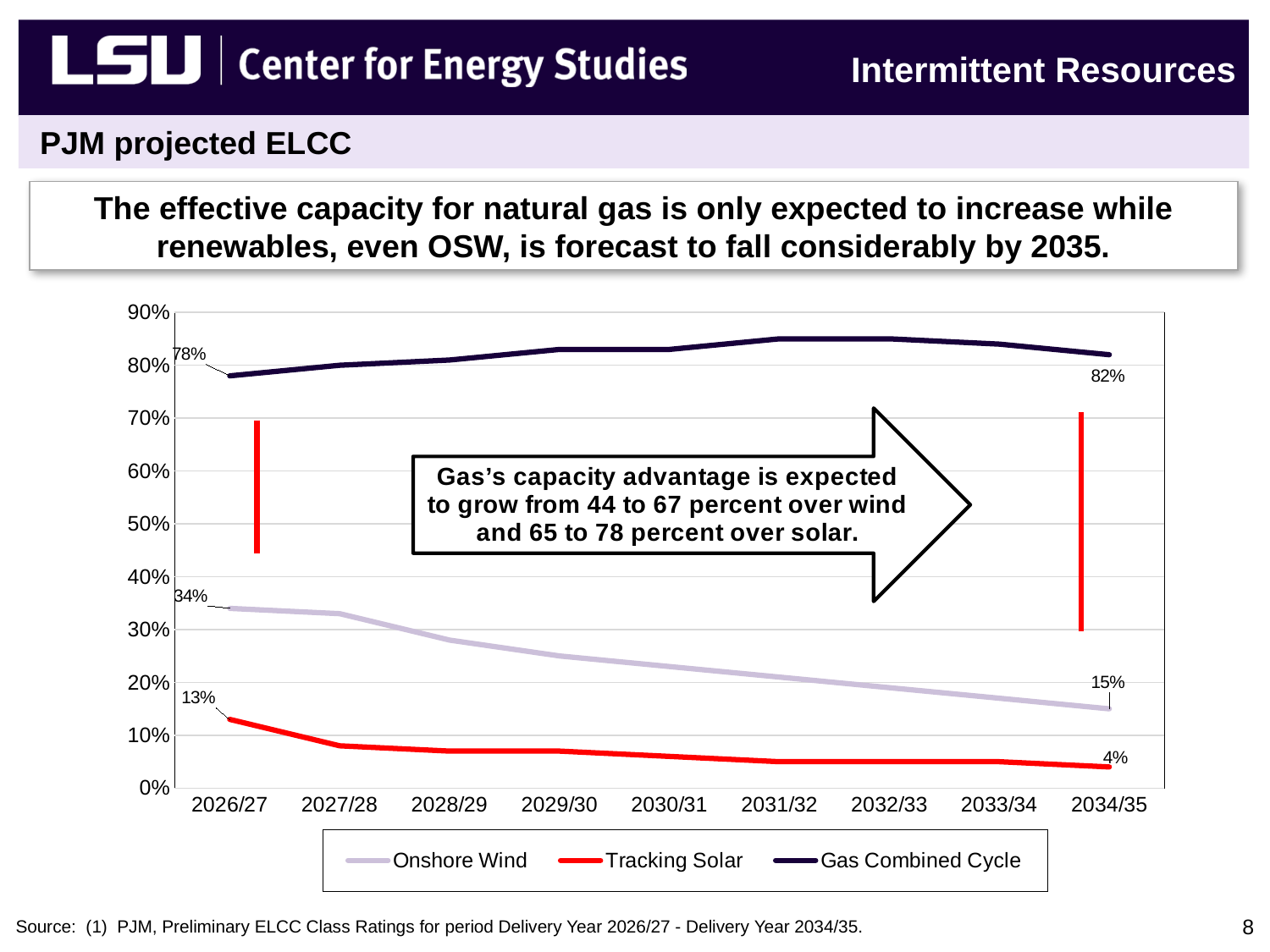
How many delivery years are shown on the x axis? 9 What is the value for Gas Combined Cycle in 2034/35? 82% What is the value for Tracking Solar in 2034/35? 4% Is the value for Onshore Wind in 2030/31 greater or less than 30%? less What is the difference between the Onshore Wind values in 2026/27 and 2034/35? 19% What is the value for Gas Combined Cycle in 2026/27? 78% What is the value for Onshore Wind in 2026/27? 34% Does the Onshore Wind series rise or fall from 2026/27 to 2034/35? fall Which series has the lowest value in 2026/27? Tracking Solar Which series has the highest value in 2034/35? Gas Combined Cycle How many series does the legend list? 3 What type of chart is shown on the slide? line chart